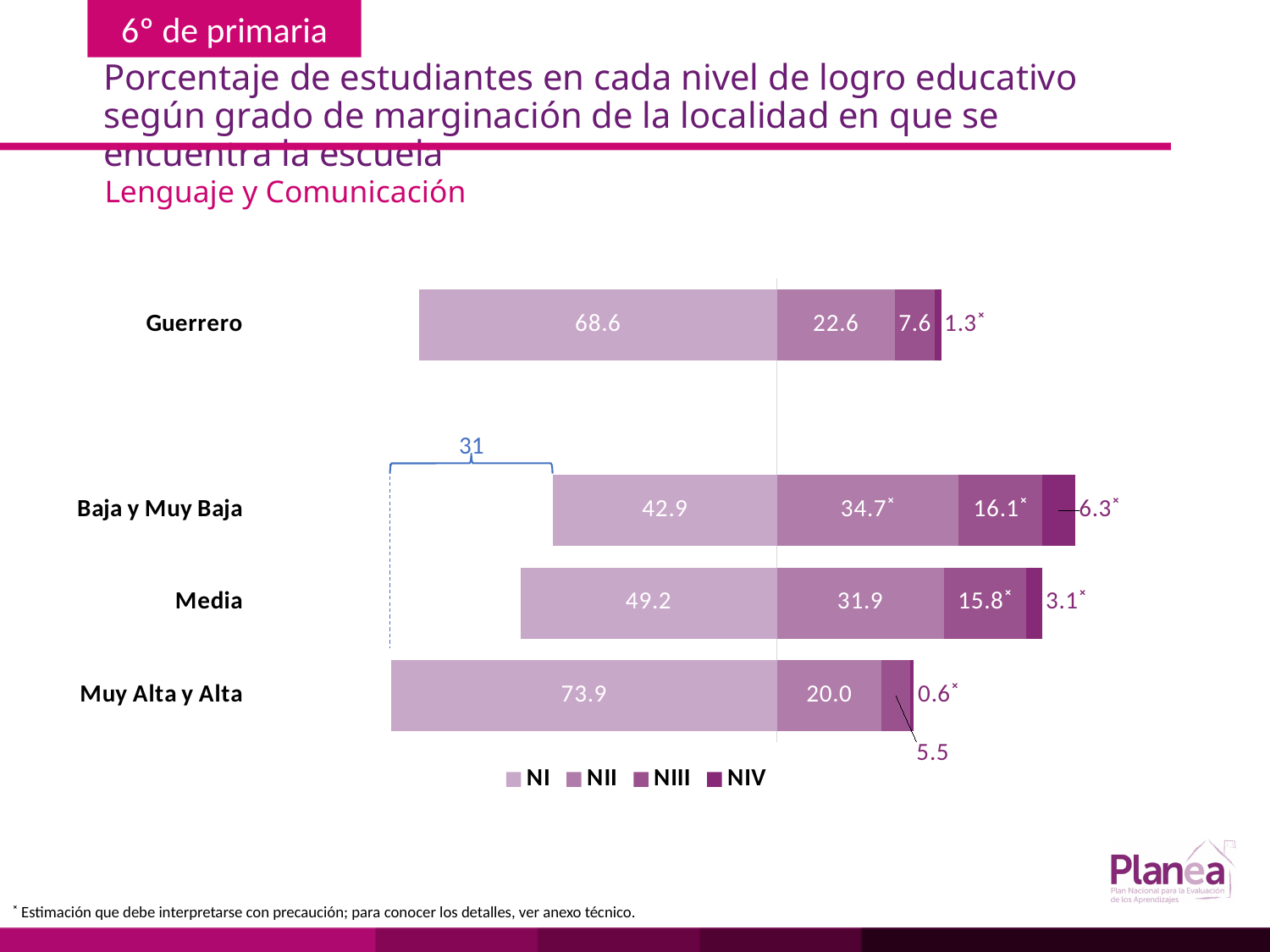
How many series does the legend list? 4 What type of chart is shown on the slide? stacked bar chart How many categories (bars) are shown in the chart? 4 Which is larger, the NII value for Guerrero or the NII value for Muy Alta y Alta? Guerrero What is the NII value for Media? 31.9 What is the difference between the NI value for Muy Alta y Alta and the NI value for Baja y Muy Baja? 31 What is the NIII value for Guerrero? 7.6 What is the NI value for Guerrero? 68.6 What is the NII value for Baja y Muy Baja? 34.7 Which category has the highest NI value? Muy Alta y Alta What is the NI value for Muy Alta y Alta? 73.9 Which category has the lowest NI value? Baja y Muy Baja